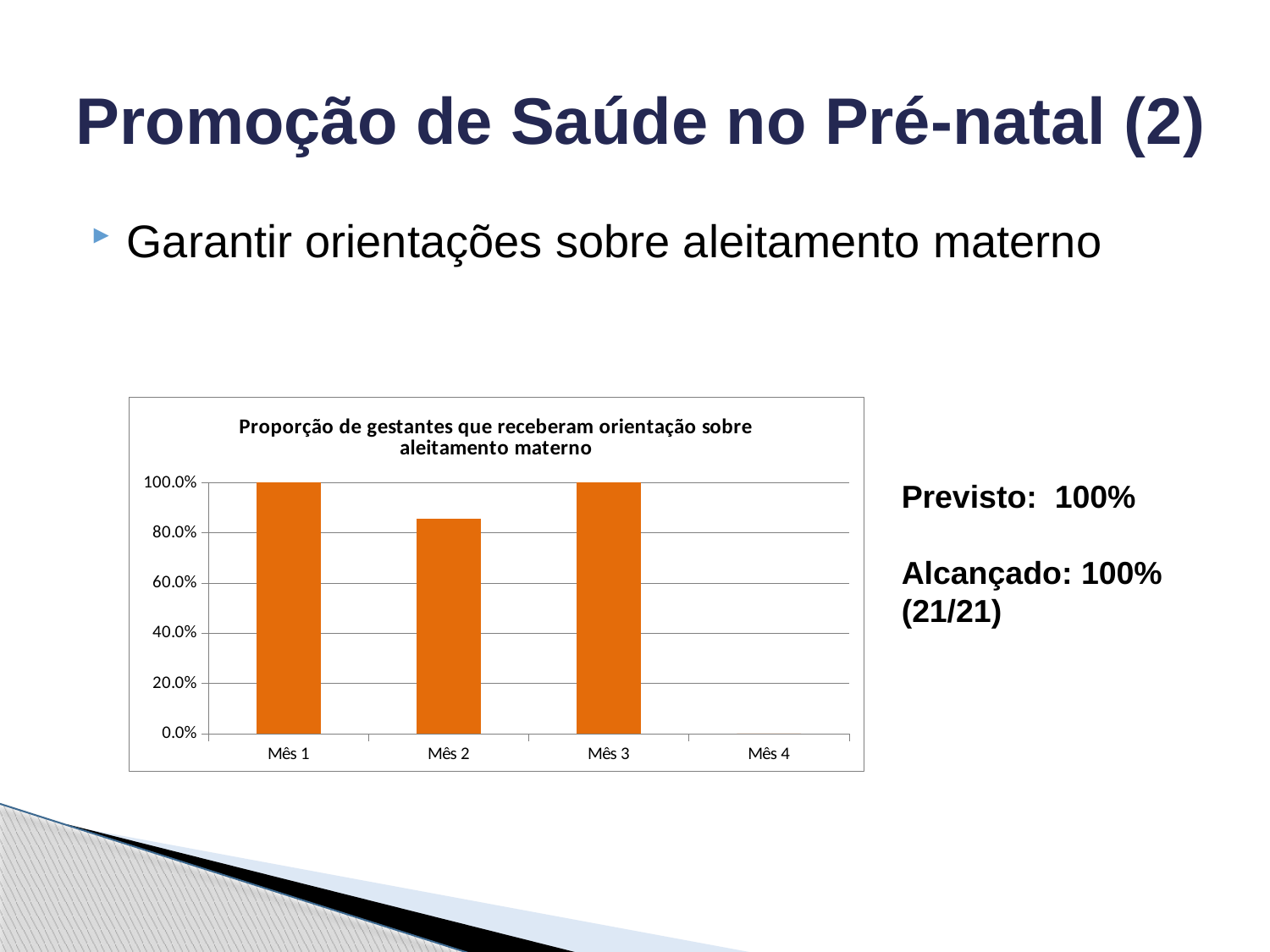
What is the value for Mês 1 in the chart? 100.0% What colour are the bars in the chart? orange Is the value for Mês 2 greater or less than 100.0%? less Does the value rise or fall from Mês 1 to Mês 2? fall Which is larger, the value for Mês 1 or the value for Mês 2? Mês 1 What is the title of the chart? Proporção de gestantes que receberam orientação sobre aleitamento materno Which category has the lowest value in the chart? Mês 4 What is the value for Mês 3 in the chart? 100.0% Which is larger, the value for Mês 3 or the value for Mês 4? Mês 3 What type of chart is shown on the slide? bar chart How many categories are shown on the x axis of the chart? 4 Is the value for Mês 2 greater or less than 80.0%? greater